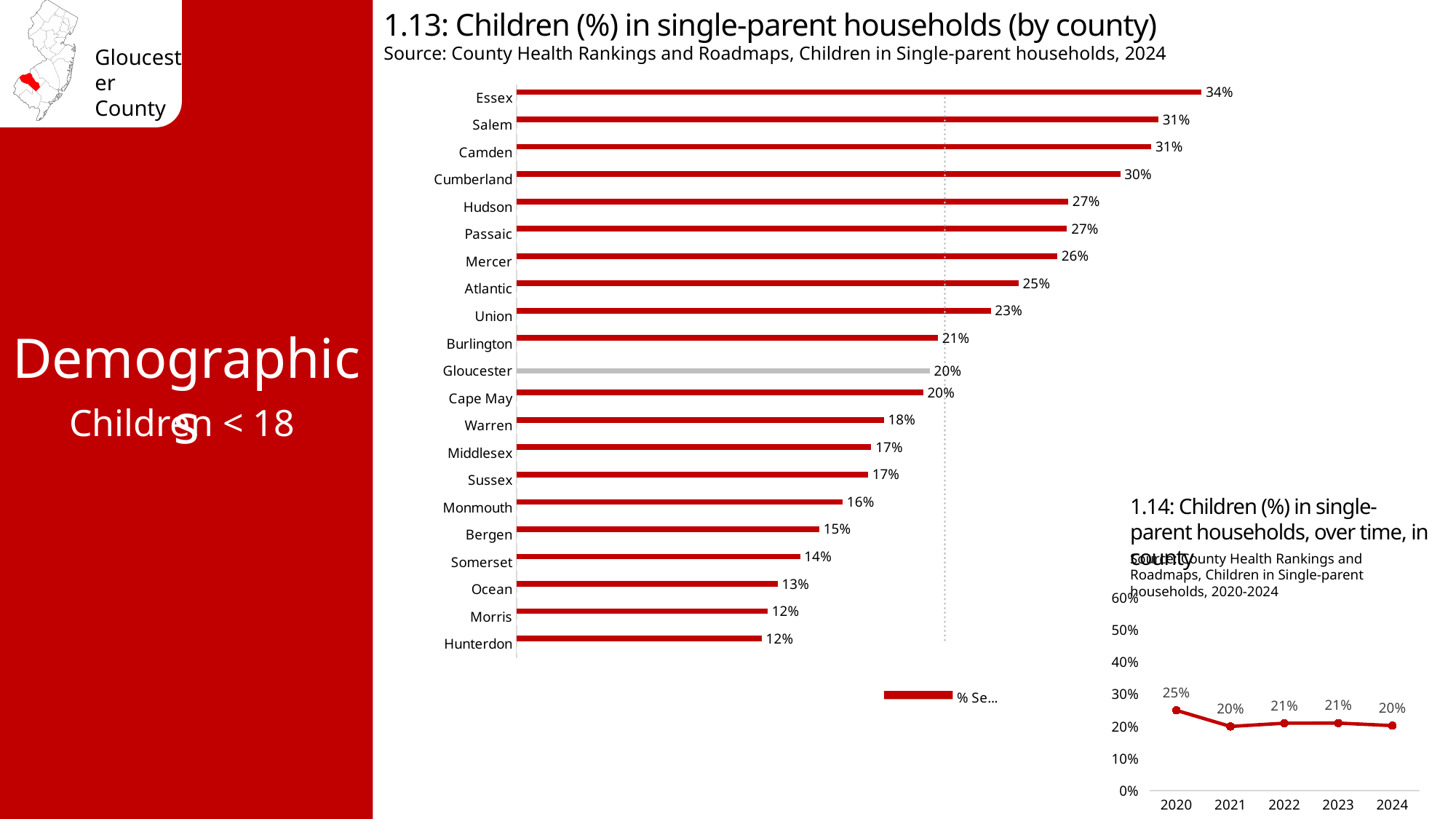
In chart 1.13, which is larger, the value for Atlantic or the value for Union? Atlantic What kind of chart is chart 1.13? Bar chart What kind of chart is chart 1.14? Line chart In chart 1.13, how many counties are shown? 21 In chart 1.13, what is the value for Monmouth? 16% In chart 1.14 (Children (%) in single-parent households over time), what is the value for 2020? 25% In chart 1.13, what is the value for Cumberland? 30% In chart 1.14, how many years are plotted? 5 In chart 1.13, what is the difference between the values for Essex and Hunterdon? 22% In chart 1.14, which year has the highest value? 2020 In chart 1.13, which county has the highest percentage of children in single-parent households? Essex In chart 1.13 (Children (%) in single-parent households by county), what is the value for Gloucester? 20%